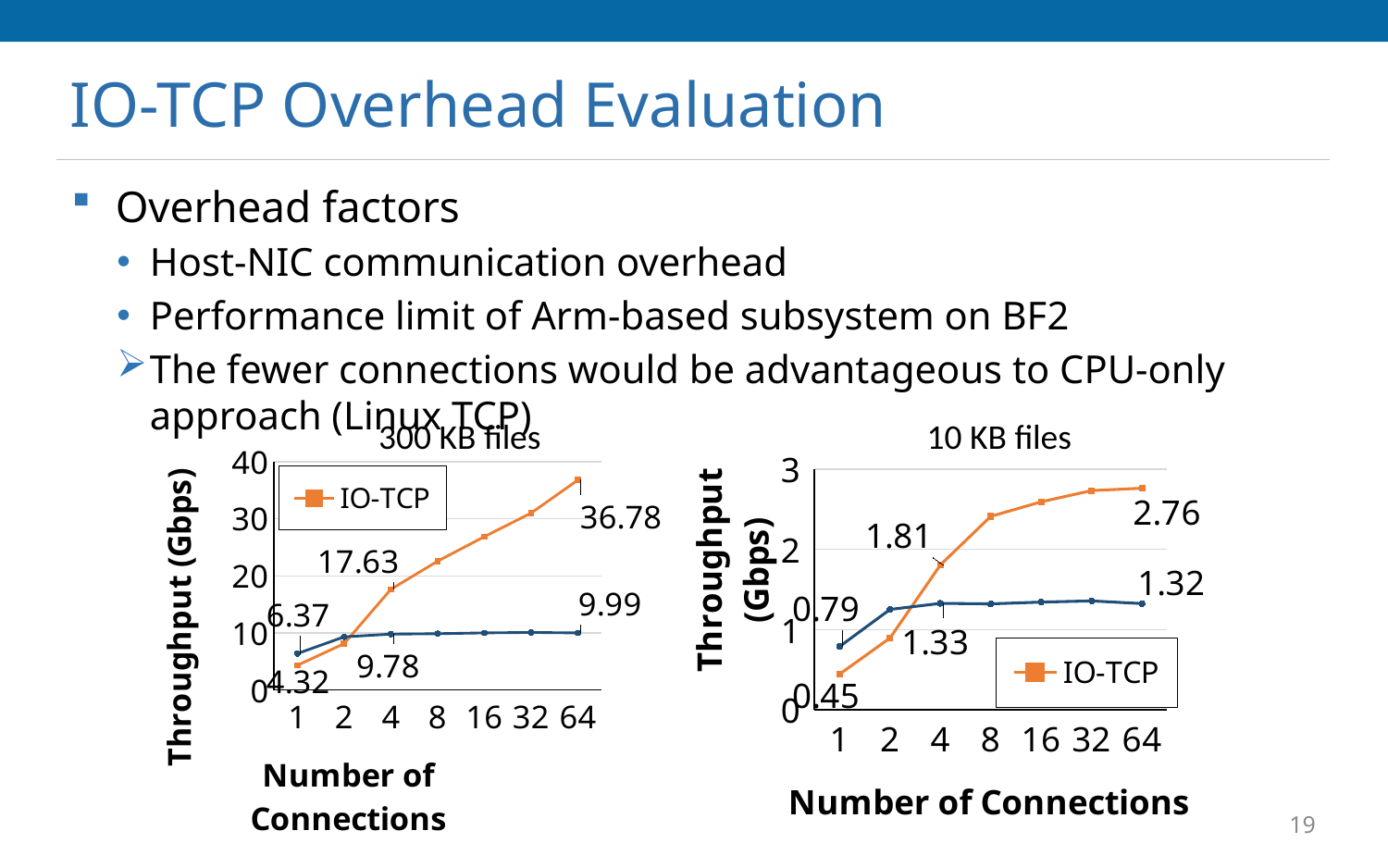
In the '300 KB files' chart, what is the difference between the IO-TCP throughput at 64 connections and at 1 connection? 32.46 In the '300 KB files' chart, what is the IO-TCP throughput at 1 connection? 4.32 In the '10 KB files' chart, does the IO-TCP throughput rise or fall as the number of connections increases? rises In the '10 KB files' chart, what is the difference between the IO-TCP throughput at 64 connections and at 1 connection? 2.31 In the '300 KB files' chart, what is the IO-TCP throughput at 4 connections? 17.63 How many series does the legend of the '10 KB files' chart list? 1 What type of chart is the '300 KB files' chart? line chart In the '300 KB files' chart, what is the IO-TCP throughput at 64 connections? 36.78 How many connection counts are shown on the x axis of the '10 KB files' chart? 7 In the '300 KB files' chart, is the IO-TCP value at 8 connections greater or less than 20? greater In the '10 KB files' chart, what is the IO-TCP throughput at 64 connections? 2.76